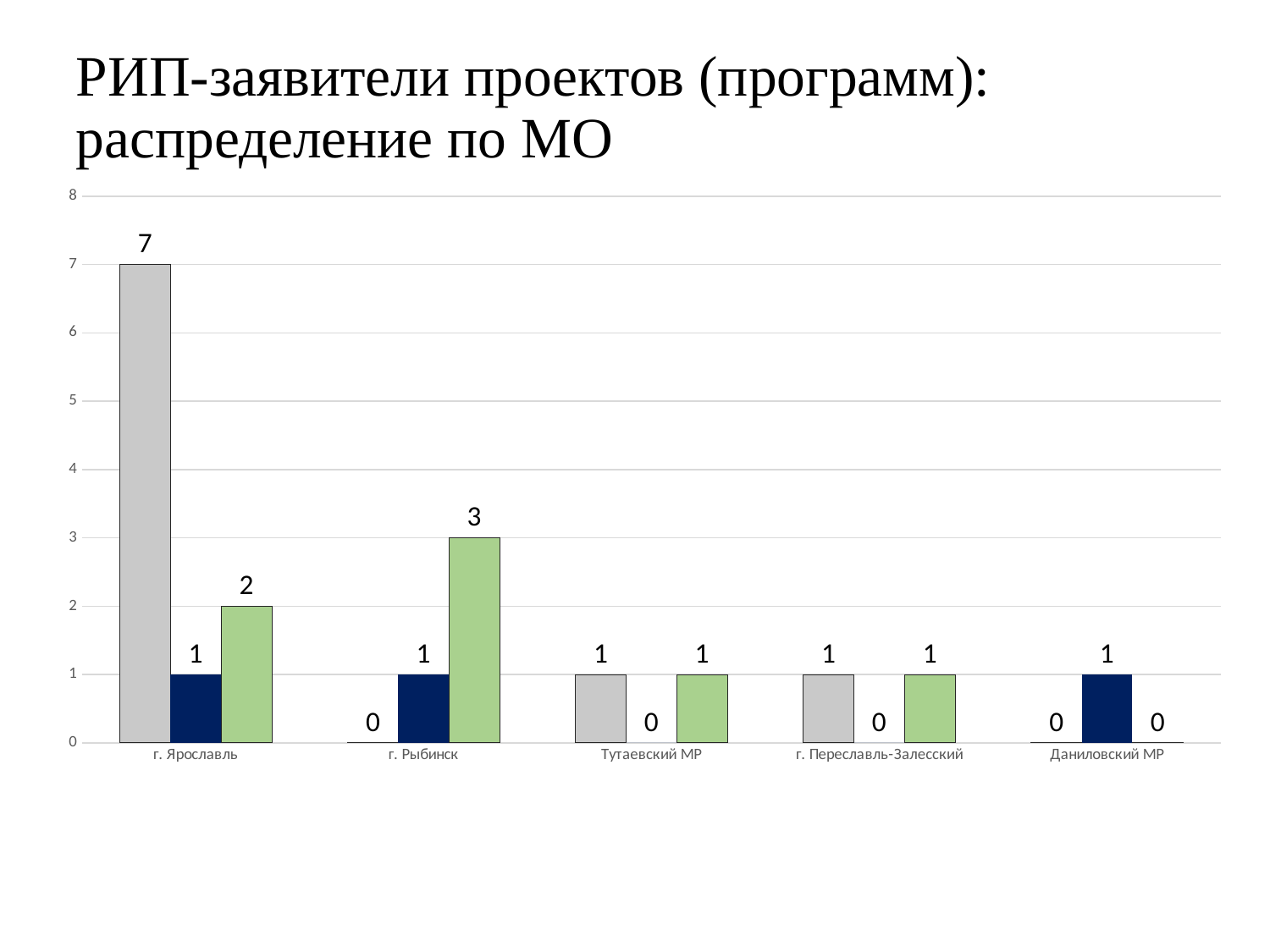
What is the difference between the grey bar and the green bar for г. Ярославль? 5 Is the grey bar for г. Ярославль greater or less than 5? greater What is the value of the grey bar for г. Рыбинск? 0 Which is larger for г. Рыбинск: the dark blue bar or the green bar? the green bar How many categories are shown on the x axis? 5 What is the value of the green bar for г. Рыбинск? 3 What type of chart is shown on the slide? bar chart What is the value of the dark blue bar for Даниловский МР? 1 Which category has the highest green bar? г. Рыбинск What is the value of the grey bar for г. Ярославль? 7 Which category has the highest grey bar? г. Ярославль What is the title of the slide containing the chart? РИП-заявители проектов (программ): распределение по МО